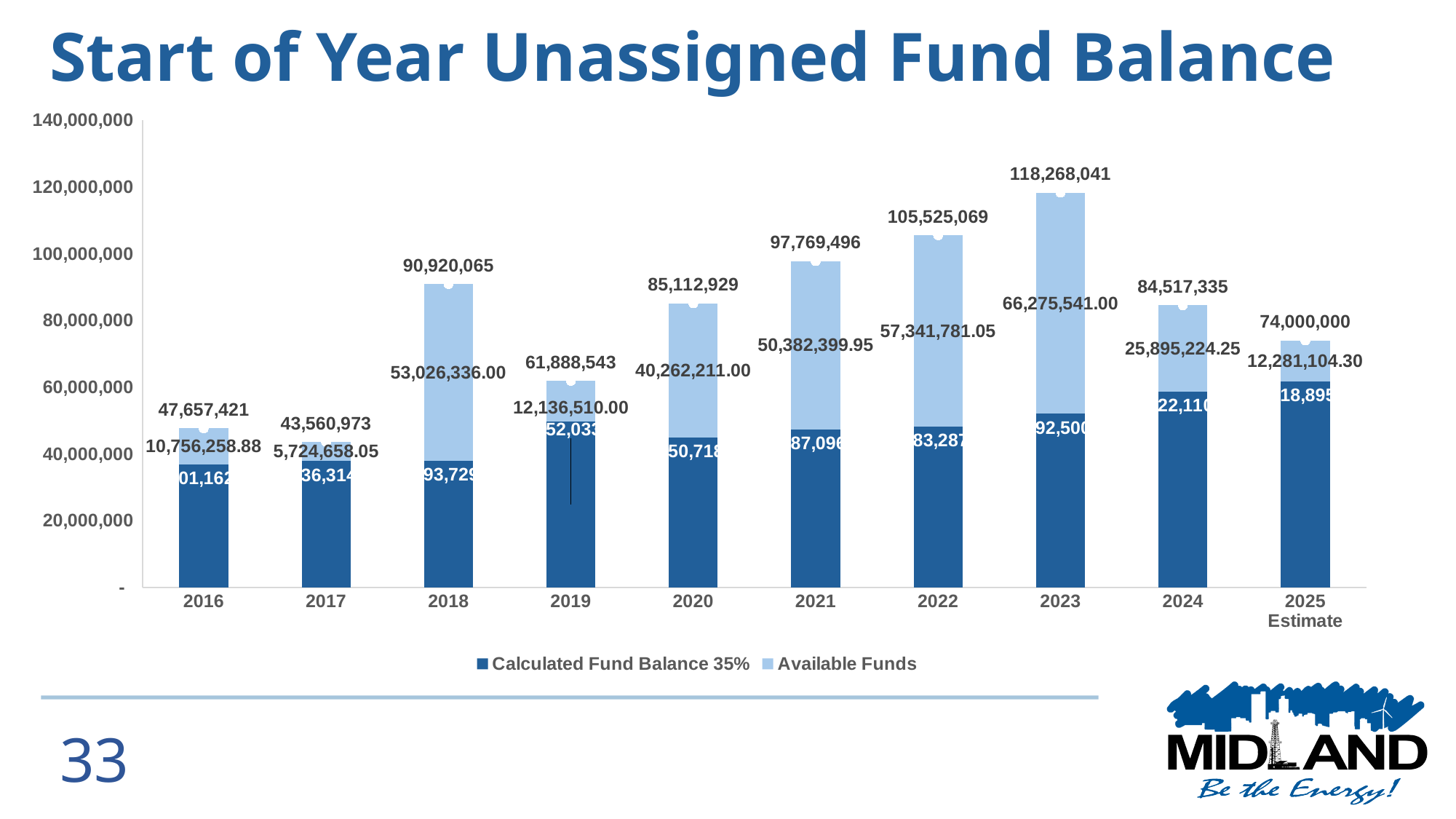
Which year has the larger total fund balance, 2018 or 2020? 2018 What kind of chart is shown on the slide? Stacked bar chart Which year has the lowest total Start of Year Unassigned Fund Balance? 2017 How many series does the legend list? 2 What is the Available Funds value for 2018? 53,026,336.00 Is the Calculated Fund Balance 35% value for 2019 greater or less than 40,000,000? greater What is the total fund balance shown for the 2025 Estimate? 74,000,000 How many years are shown on the x axis of the chart? 10 Which year has the lowest Available Funds value? 2017 What is the total Start of Year Unassigned Fund Balance shown for 2023? 118,268,041 Which year has the highest total Start of Year Unassigned Fund Balance? 2023 What is the difference between the total fund balance in 2023 and in 2022? 12,742,972